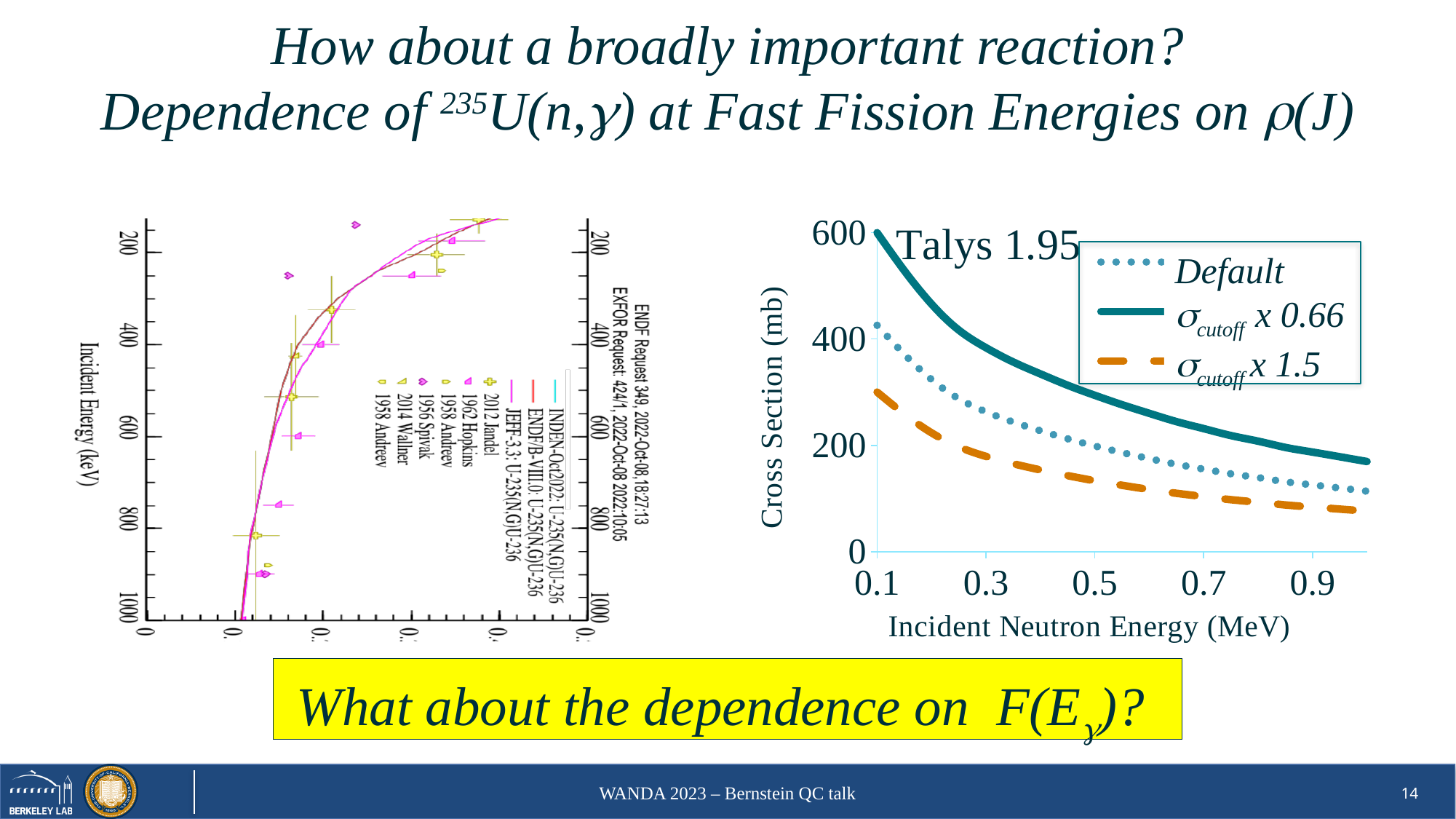
In the Talys 1.95 chart on the right, what is the label of the x axis? Incident Neutron Energy (MeV) In the Talys 1.95 chart on the right, which series has the lowest cross section across the energy range? σcutoff x 1.5 In the Talys 1.95 chart on the right, what kind of chart is it? line chart In the Talys 1.95 chart on the right, does the cross section rise or fall as incident neutron energy increases? fall In the Talys 1.95 chart on the right, is the Default cross section at 0.9 MeV greater or less than 200 mb? less In the Talys 1.95 chart on the right, is the σcutoff x 0.66 cross section at 0.1 MeV greater or less than 400 mb? greater In the Talys 1.95 chart on the right, how many series does the legend list? 3 In the Talys 1.95 chart on the right, is the σcutoff x 0.66 cross section at 0.5 MeV greater or less than 200 mb? greater In the Talys 1.95 chart on the right, which series has the highest cross section across the energy range? σcutoff x 0.66 In the Talys 1.95 chart on the right, which is larger at 0.3 MeV: the Default cross section or the σcutoff x 1.5 cross section? Default In the Talys 1.95 chart on the right, which series is drawn with a dashed orange line? σcutoff x 1.5